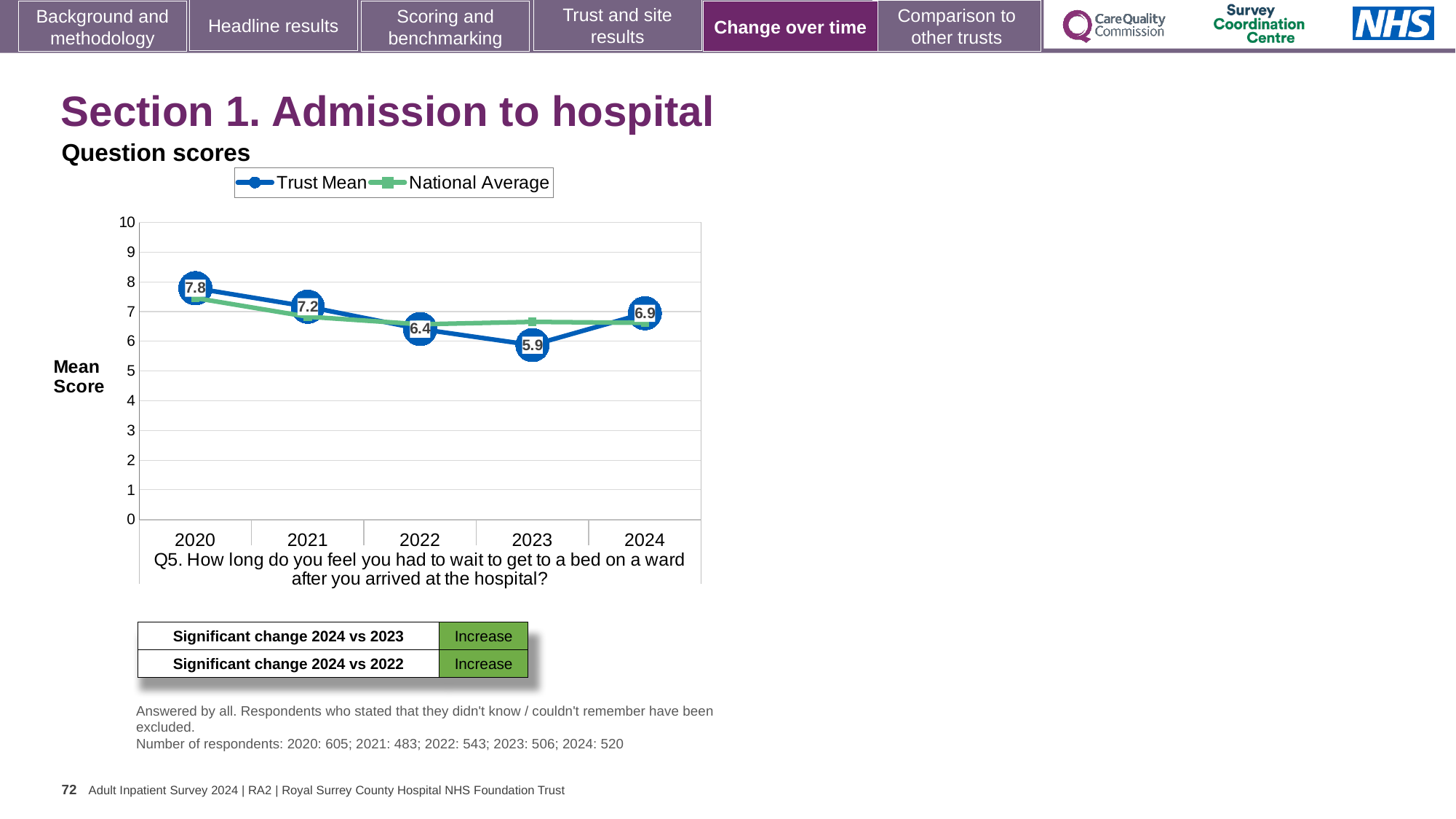
Does the Trust Mean score rise or fall from 2020 to 2023? Fall Is the National Average value for 2023 greater or less than 6? greater What is the difference between the Trust Mean scores for 2020 and 2023? 1.9 What is the Trust Mean score for 2023? 5.9 What is the Trust Mean score for 2024? 6.9 In which year is the Trust Mean score highest? 2020 How many years are shown on the x axis? 5 How many series does the legend list? 2 What is the Trust Mean score for 2020? 7.8 Which is larger, the Trust Mean score for 2021 or for 2022? 2021 In which year is the Trust Mean score lowest? 2023 What kind of chart is shown? Line chart